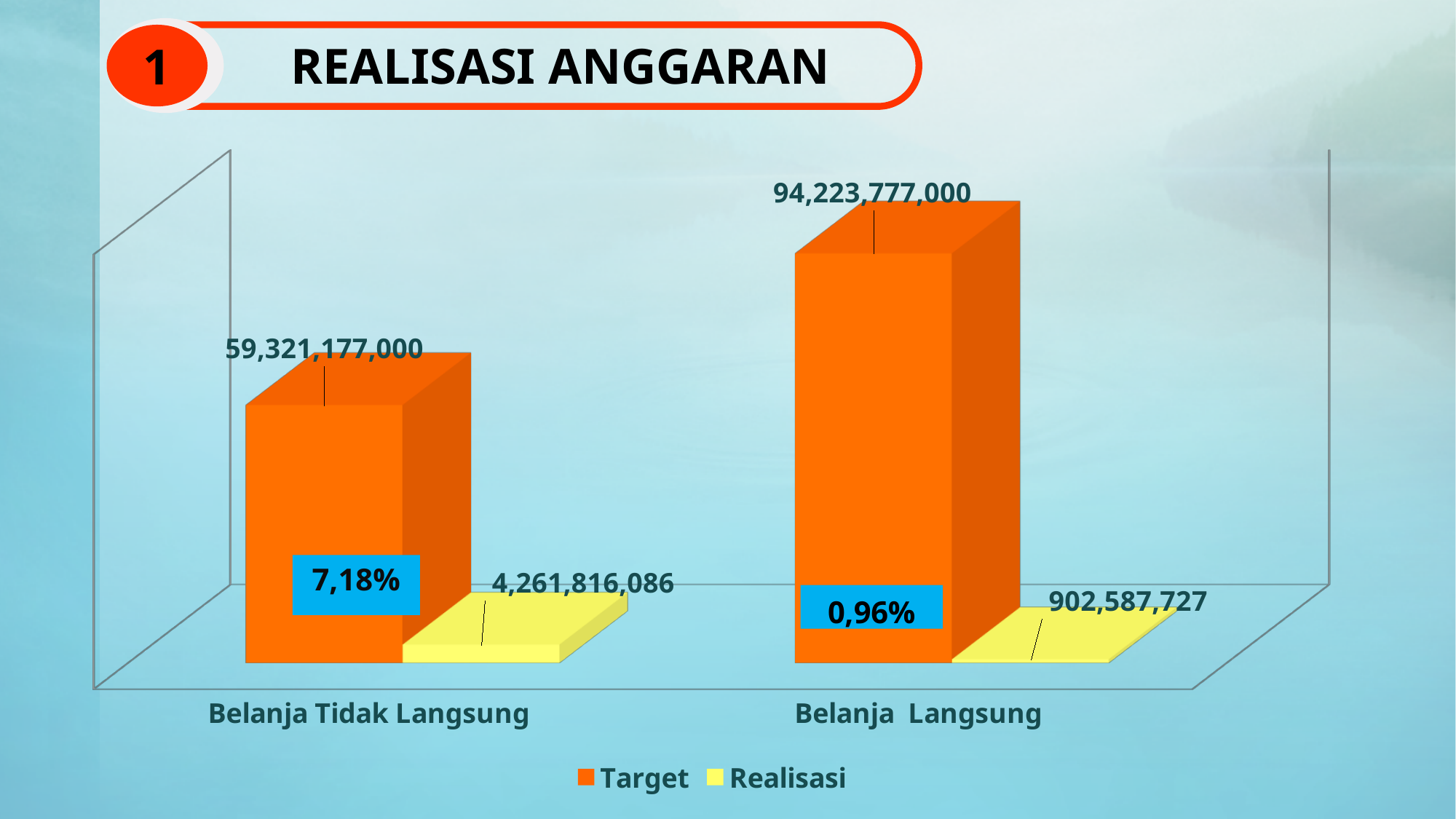
How many series does the legend list? 2 Is the Realisasi value for Belanja Tidak Langsung larger or smaller than the Realisasi value for Belanja Langsung? larger What percentage is shown on the Belanja Langsung bar? 0,96% What type of chart is shown on the slide? bar chart Which category has the lower Realisasi value? Belanja Langsung What is the Realisasi value for Belanja Langsung? 902,587,727 What is the Target value for Belanja Tidak Langsung? 59,321,177,000 What is the difference between the Target values for Belanja Langsung and Belanja Tidak Langsung? 34,902,600,000 Which category has the higher Target value? Belanja Langsung What is the Realisasi value for Belanja Tidak Langsung? 4,261,816,086 What percentage is shown on the Belanja Tidak Langsung bar? 7,18% What is the Target value for Belanja Langsung? 94,223,777,000